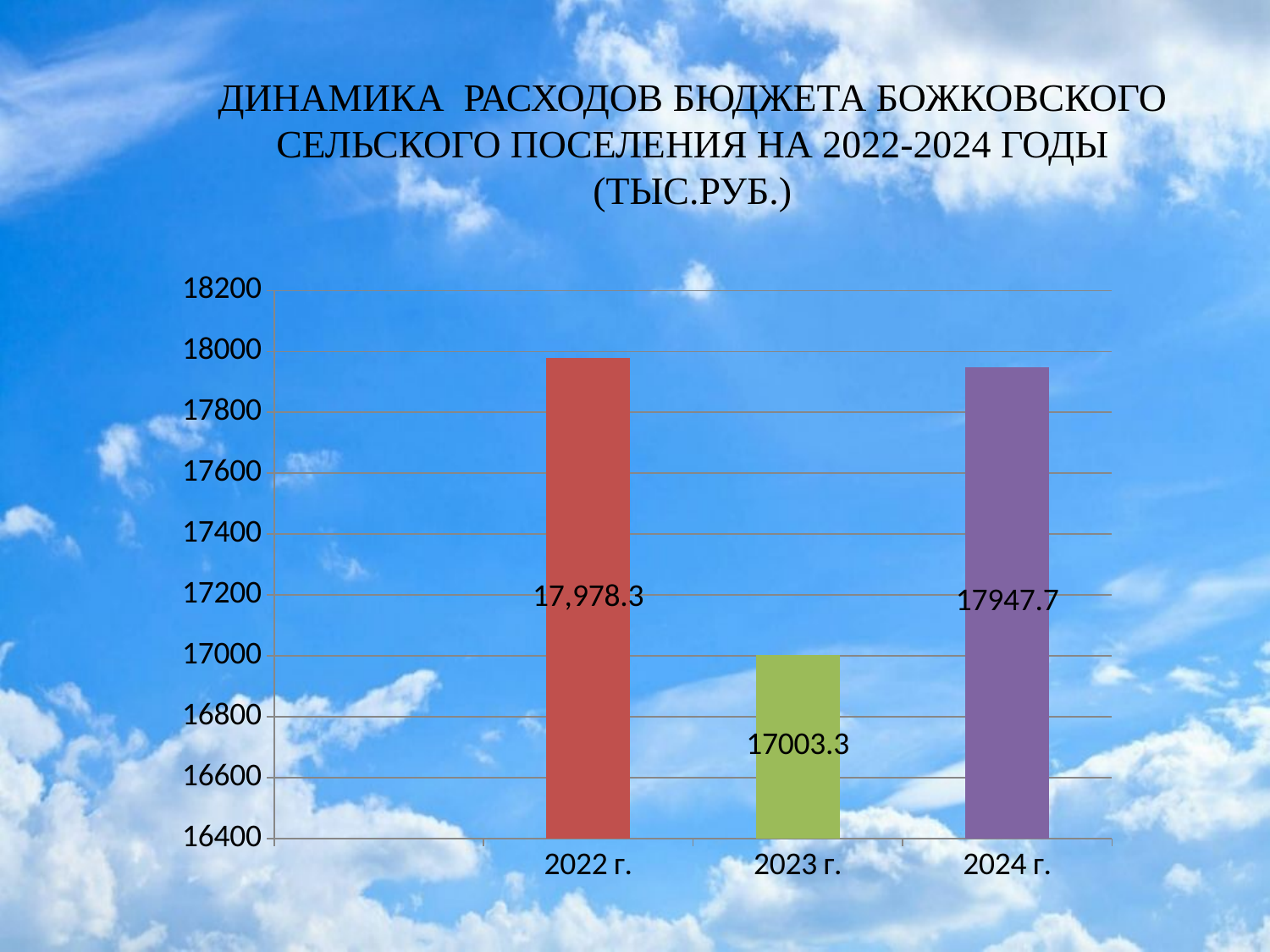
What unit is given in the chart title? ТЫС.РУБ. Which is larger, the value for 2022 г. or the value for 2024 г.? 2022 г. What kind of chart is shown on the slide? bar chart What is the value for 2024 г.? 17947.7 Which year has the lowest value? 2023 г. What is the difference between the values for 2024 г. and 2023 г.? 944.4 What is the value for 2023 г.? 17003.3 Is the value for 2023 г. greater or less than 17200? less Which year has the highest value? 2022 г. What is the value for 2022 г.? 17,978.3 How many years are shown on the chart? 3 What is the difference between the values for 2022 г. and 2023 г.? 975.0